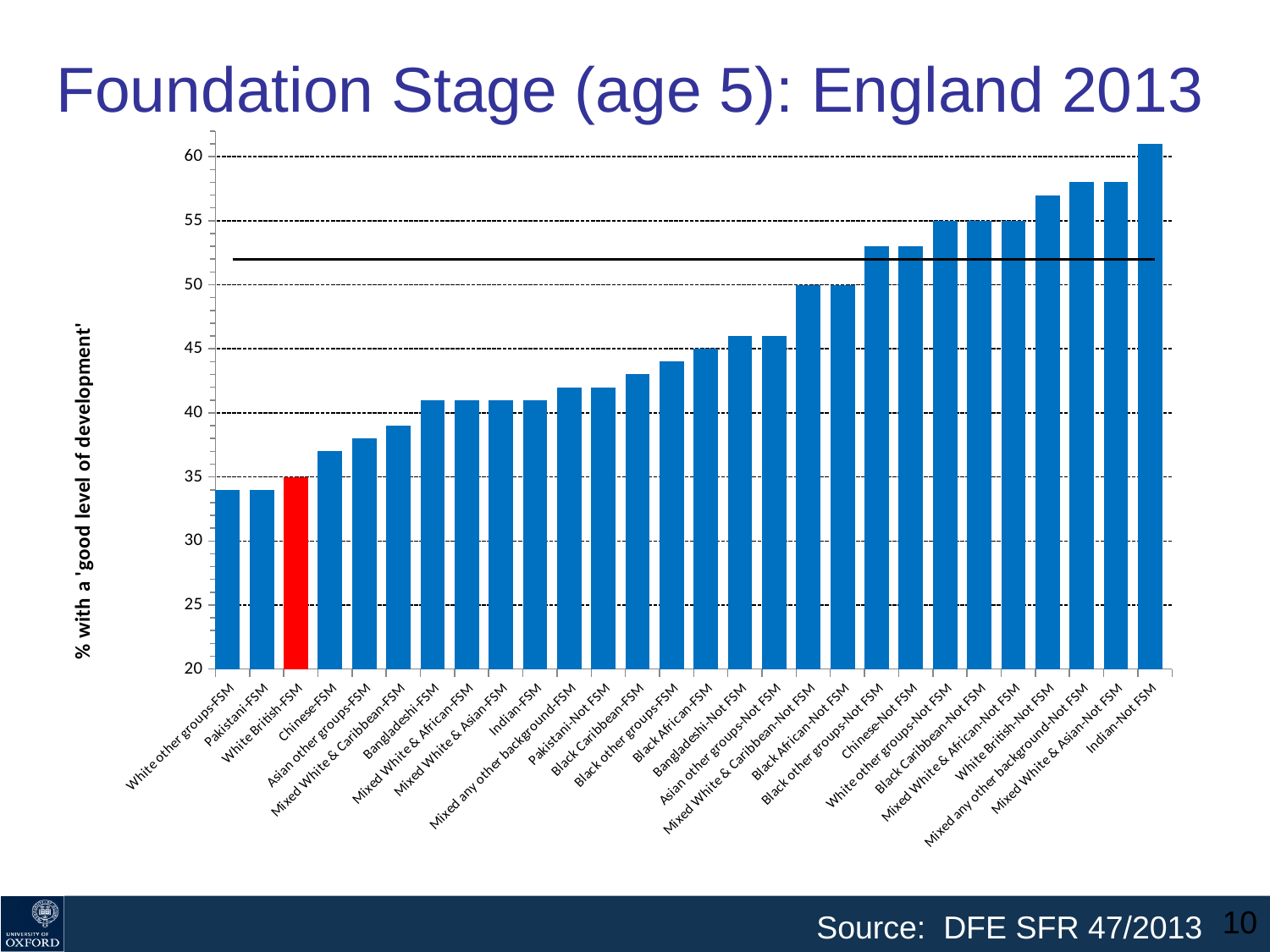
Do the values generally rise or fall from left to right along the x axis? rise What is the value for Black African-FSM? 45 Which is larger, the value for Indian-Not FSM or the value for Indian-FSM? Indian-Not FSM What kind of chart is shown on the slide? bar chart How many ethnic group categories are plotted on the chart? 28 Is the value for Chinese-FSM greater or less than 40? less Is the value for Indian-Not FSM greater or less than 60? greater Which category has the highest value on the chart? Indian-Not FSM Which category's bar is coloured red? White British-FSM What is the value for Black African-Not FSM? 50 What is the value for White British-FSM? 35 Is the value for White British-Not FSM greater or less than 55? greater